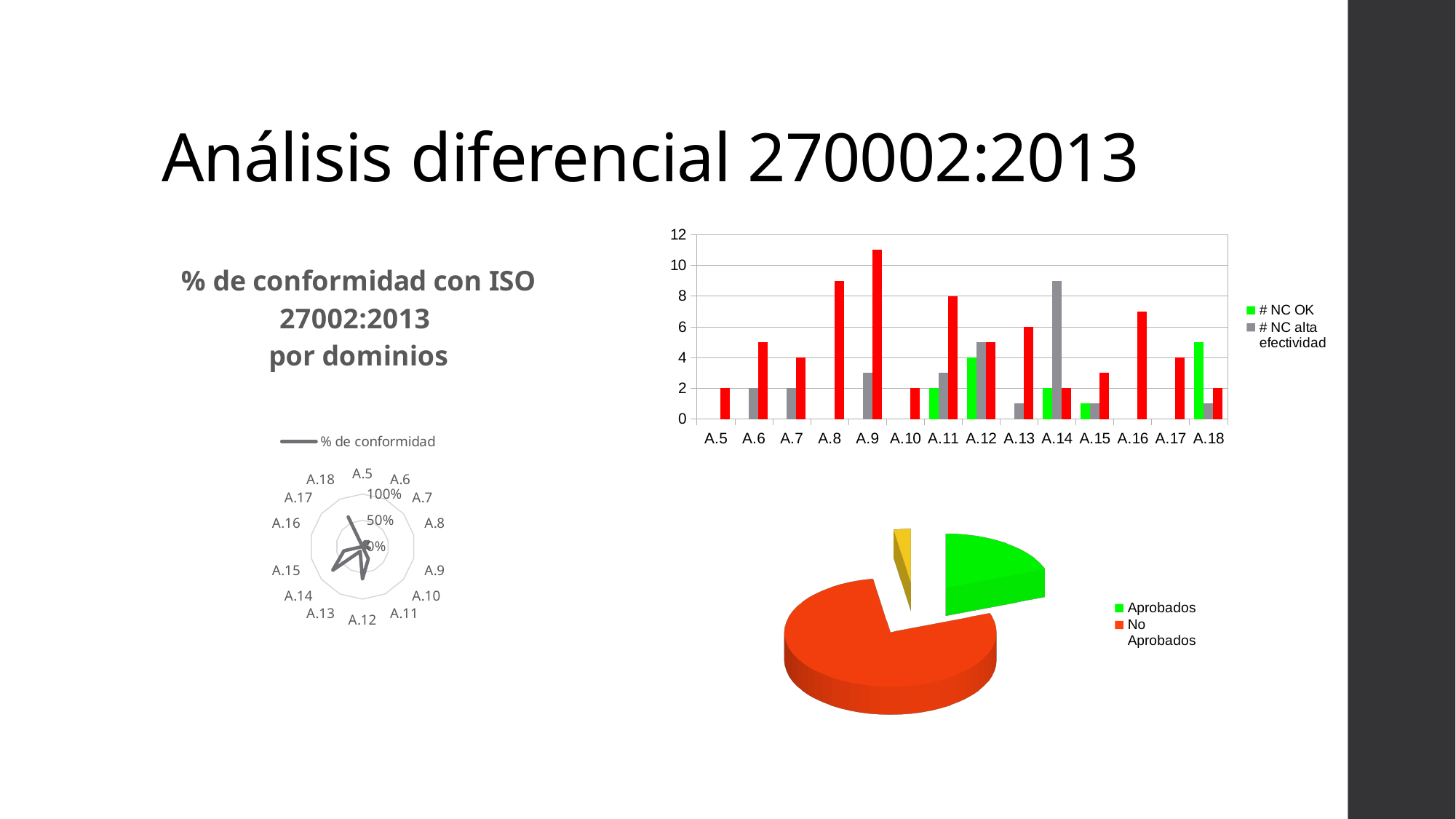
In the bar chart at the top right, which category has the tallest red bar? A.9 In the bar chart at the top right, is the red bar for A.9 greater or less than 10? greater What kind of chart is the chart at the top right of the slide? bar chart In the bar chart at the top right, what is the value of the red bar for A.11? 8 In the bar chart at the top right, what is the value of the red bar for A.7? 4 In the bar chart at the top right, how many categories are shown on the x axis? 14 What is the title of the radar chart on the left of the slide? % de conformidad con ISO 27002:2013 por dominios In the bar chart at the top right, is the red bar for A.13 larger or smaller than the red bar for A.15? larger In the bar chart at the top right, what is the value of the # NC OK bar for A.12? 4 In the bar chart at the top right, which category has the tallest # NC alta efectividad bar? A.14 What kind of chart is the chart at the bottom right of the slide? pie chart In the pie chart at the bottom right, which slice is the largest? No Aprobados